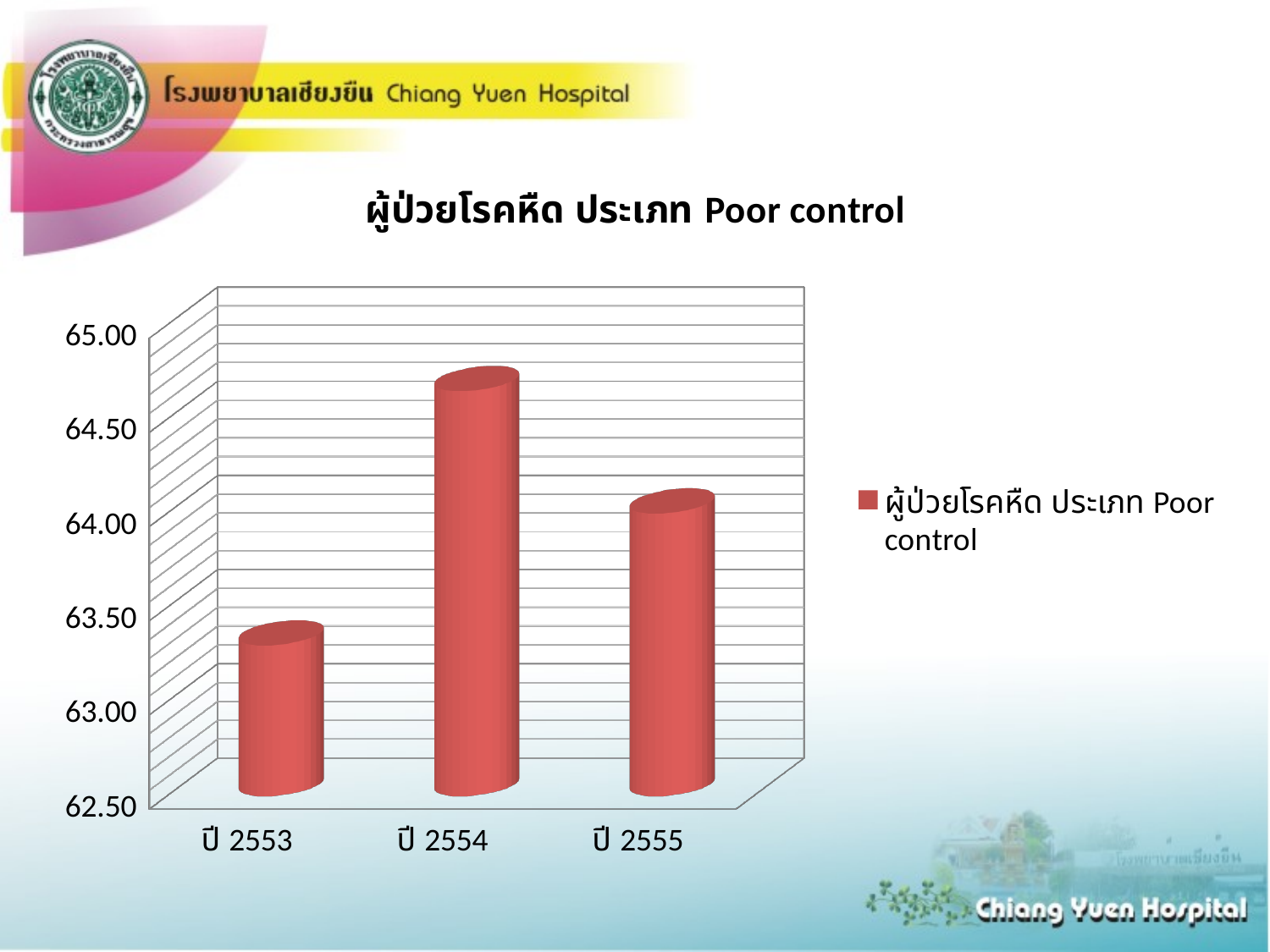
Is the value for ปี 2554 greater or less than 64.50? greater Which is larger, the value for ปี 2553 or ปี 2555? ปี 2555 Is the value for ปี 2553 greater or less than 63.50? less Which is larger, the value for ปี 2554 or ปี 2555? ปี 2554 Which year has the highest value? ปี 2554 Which year has the lowest value? ปี 2553 How many categories (years) are shown on the x axis? 3 How many series does the legend list? 1 What kind of chart is shown on the slide? Bar chart Do the values rise or fall from ปี 2554 to ปี 2555? fall Is the value for ปี 2555 greater or less than 64.50? less What is the title of the chart? ผู้ป่วยโรคหืด ประเภท Poor control